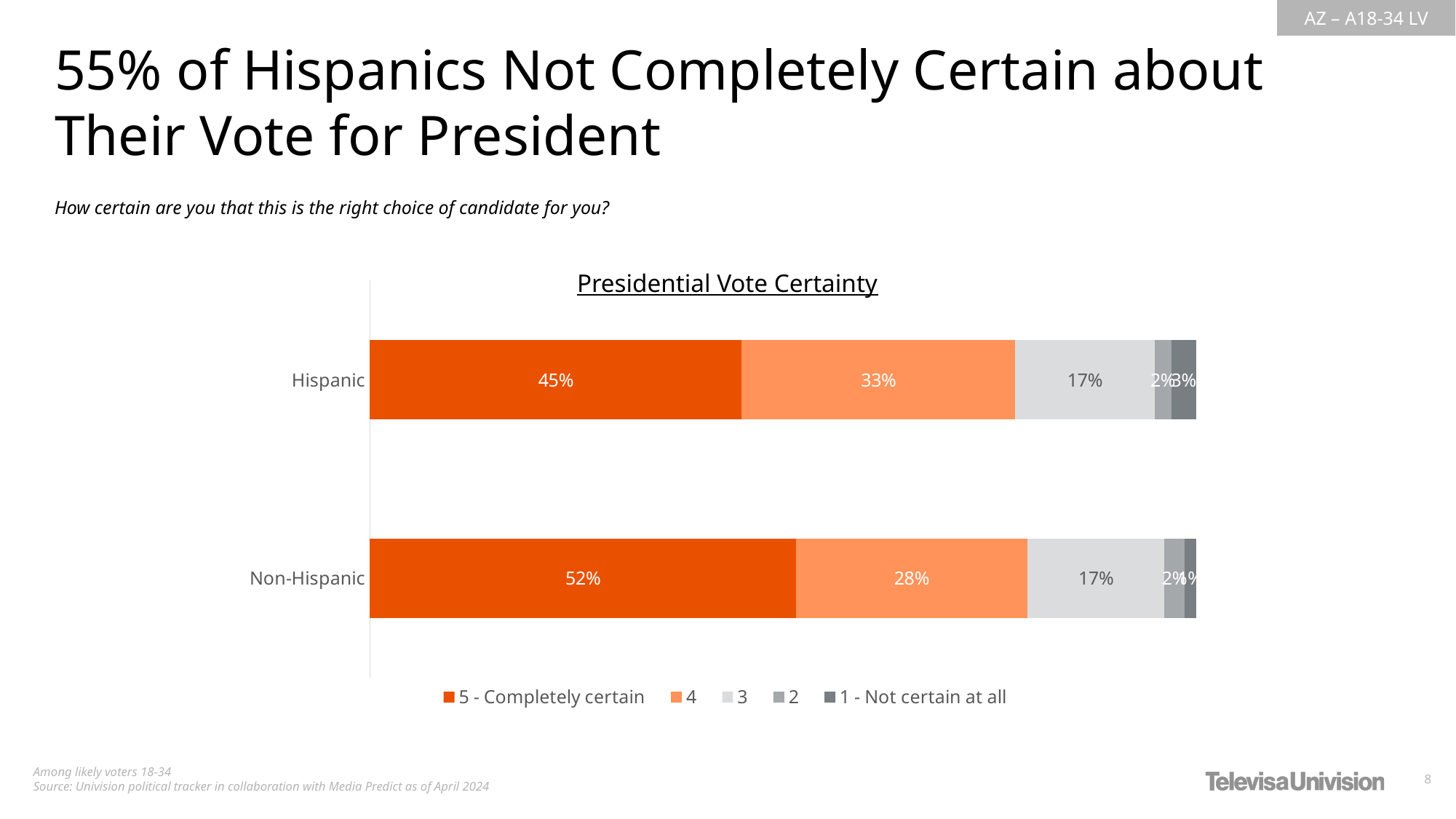
Which group has the larger share of '5 - Completely certain', Hispanic or Non-Hispanic? Non-Hispanic What percentage of Hispanic respondents are '5 - Completely certain'? 45% What percentage of Non-Hispanic respondents are '5 - Completely certain'? 52% What is the value of the '3' segment for Hispanic respondents? 17% How many categories (groups) are plotted in the chart? 2 What is the value of the '4' segment for Non-Hispanic respondents? 28% What kind of chart is shown on the slide? Stacked bar chart How many series does the legend list? 5 What is the difference in the '5 - Completely certain' share between Non-Hispanic and Hispanic respondents? 7 percentage points What is the value of the '4' segment for Hispanic respondents? 33% Which series is the largest segment in the Hispanic bar? 5 - Completely certain What is the title of the chart? Presidential Vote Certainty